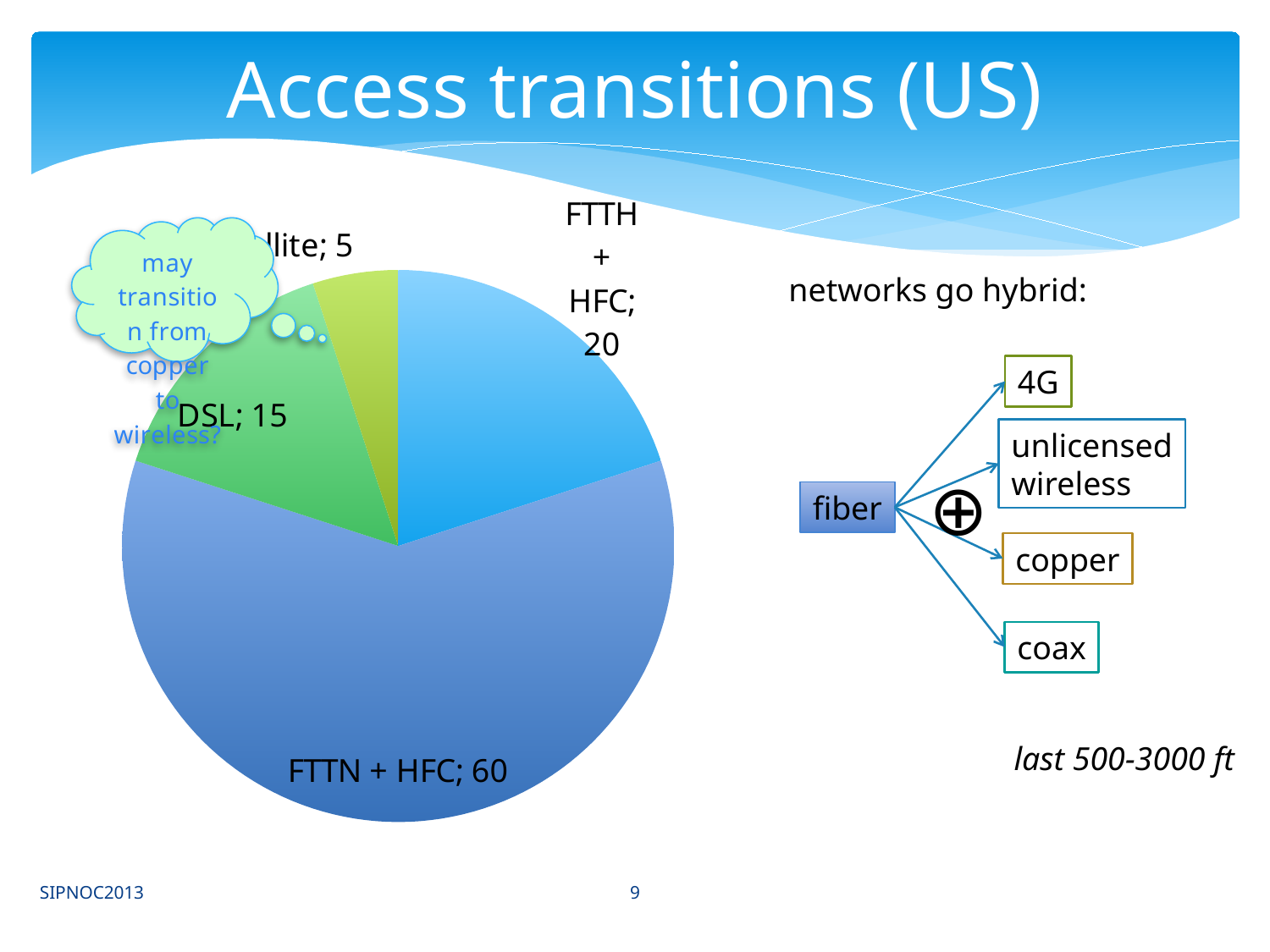
What is the difference between the values for FTTH + HFC and DSL? 5 What is the total of all the slice values in the pie chart? 100 What is the value for FTTN + HFC in the pie chart? 60 Which slice of the pie chart is the largest? FTTN + HFC What is the value for DSL in the pie chart? 15 What kind of chart is shown on the slide? pie chart How many slices does the pie chart have? 4 What is the value for FTTH + HFC in the pie chart? 20 What share of the pie does the FTTN + HFC slice represent? 60% What is the title of the slide containing the pie chart? Access transitions (US) What is the difference between the values for FTTN + HFC and FTTH + HFC? 40 Which is larger, the value for DSL or the value for FTTH + HFC? FTTH + HFC